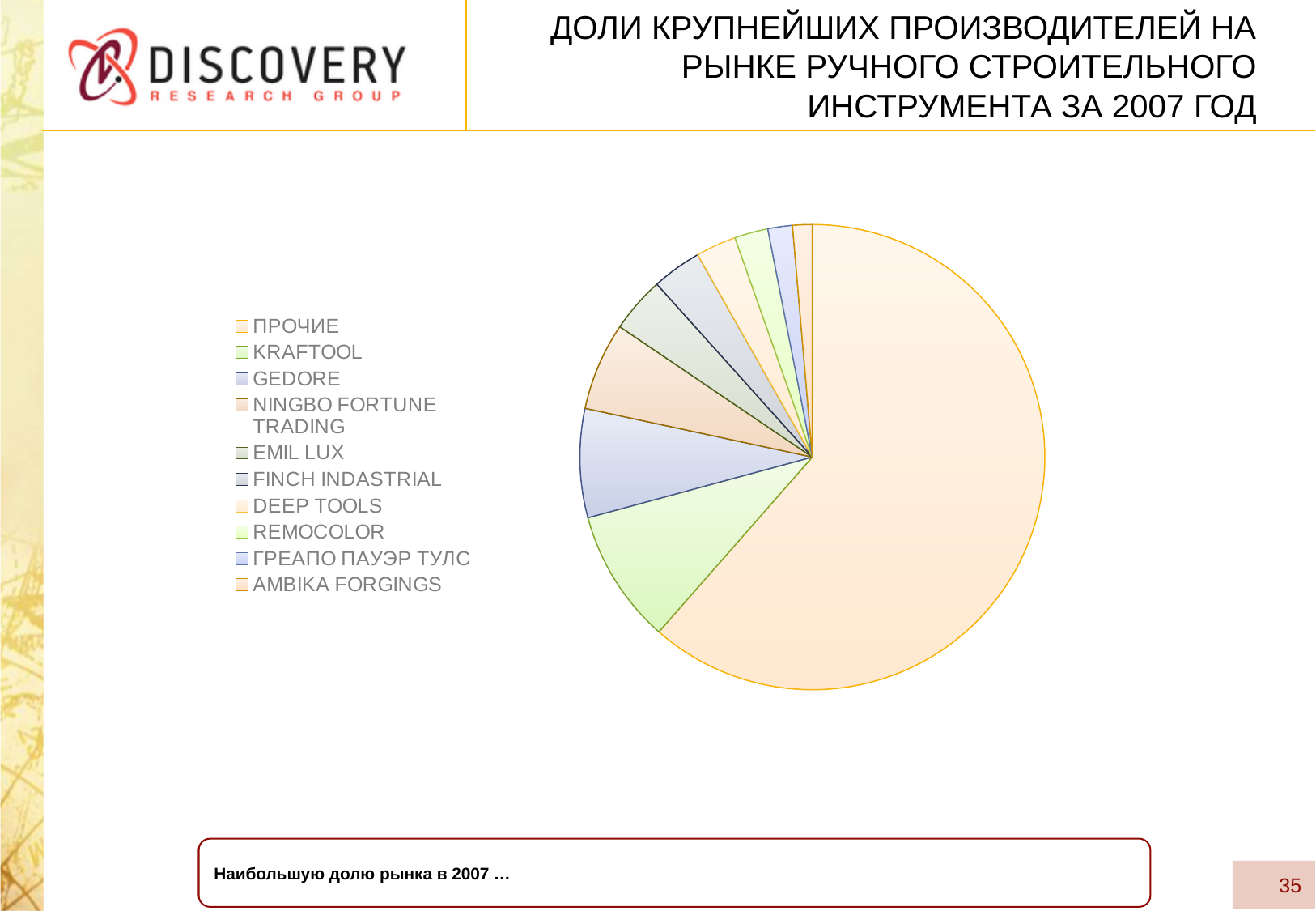
How many categories does the pie chart's legend list? 10 Which category has the second-largest slice of the pie? KRAFTOOL Which category is listed first in the legend? ПРОЧИЕ Which category has the largest slice of the pie? ПРОЧИЕ Which slice is larger, ПРОЧИЕ or KRAFTOOL? ПРОЧИЕ Which slice is larger, GEDORE or AMBIKA FORGINGS? GEDORE Which year does the chart title say the market shares refer to? 2007 What kind of chart is shown on the slide? pie chart Which slice is larger, KRAFTOOL or GEDORE? KRAFTOOL Does the ПРОЧИЕ slice take up more or less than half of the pie? more